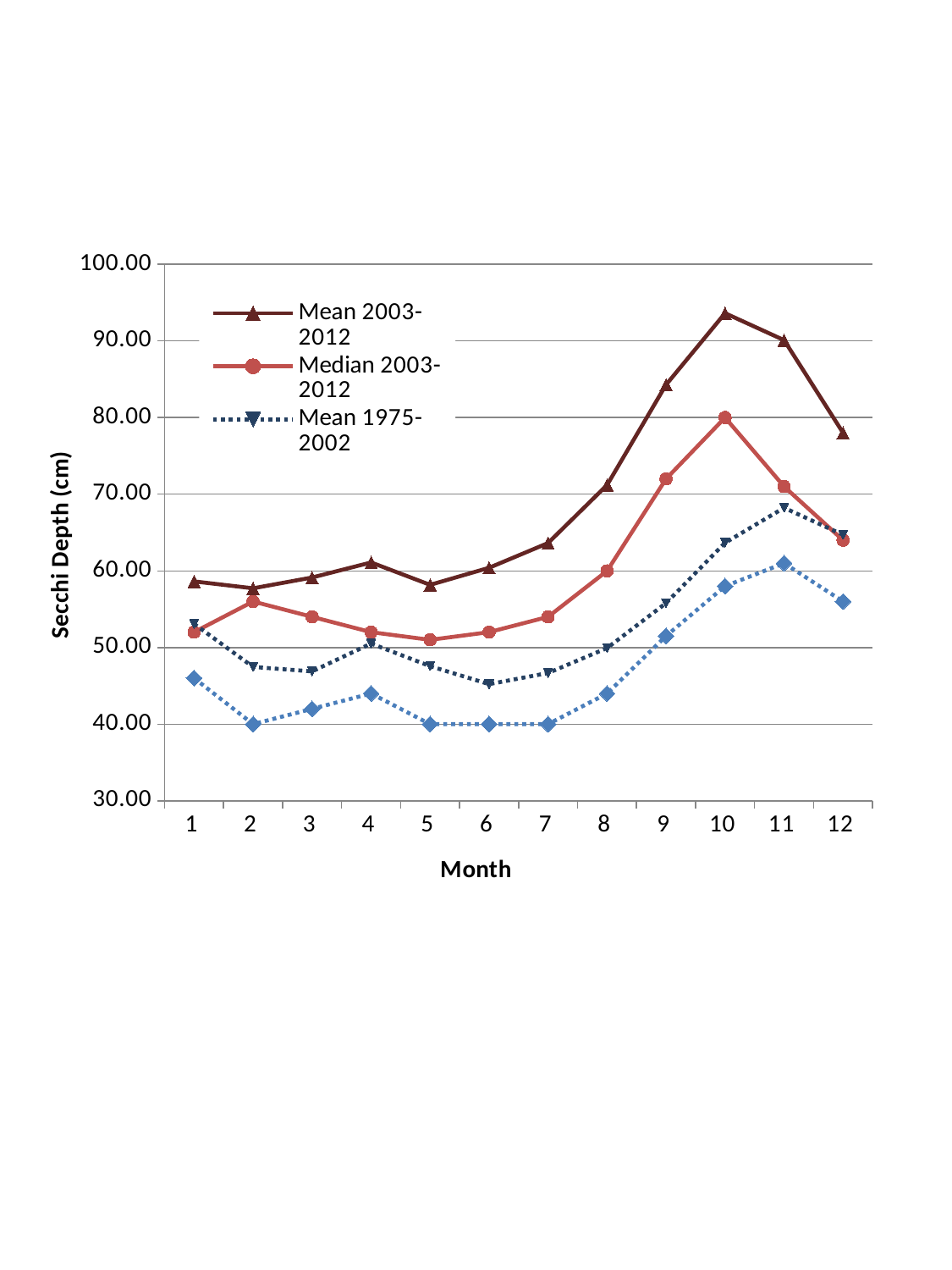
What kind of chart is shown on the slide? line chart Does the Mean 2003-2012 series rise or fall from month 7 to month 10? rise In which month does the Mean 2003-2012 series reach its highest value? 10 Is the Median 2003-2012 value for month 9 greater or less than 70.00? greater Is the Mean 1975-2002 value for month 6 greater or less than 50.00? less How many series does the legend list? 3 In which month does the Median 2003-2012 series reach its highest value? 10 What is the title of the vertical axis? Secchi Depth (cm) In month 12, which is larger: the Mean 2003-2012 value or the Median 2003-2012 value? Mean 2003-2012 Is the Mean 2003-2012 value for month 10 greater or less than 90.00? greater How many months are plotted along the x axis? 12 In which month does the Mean 1975-2002 series reach its highest value? 11